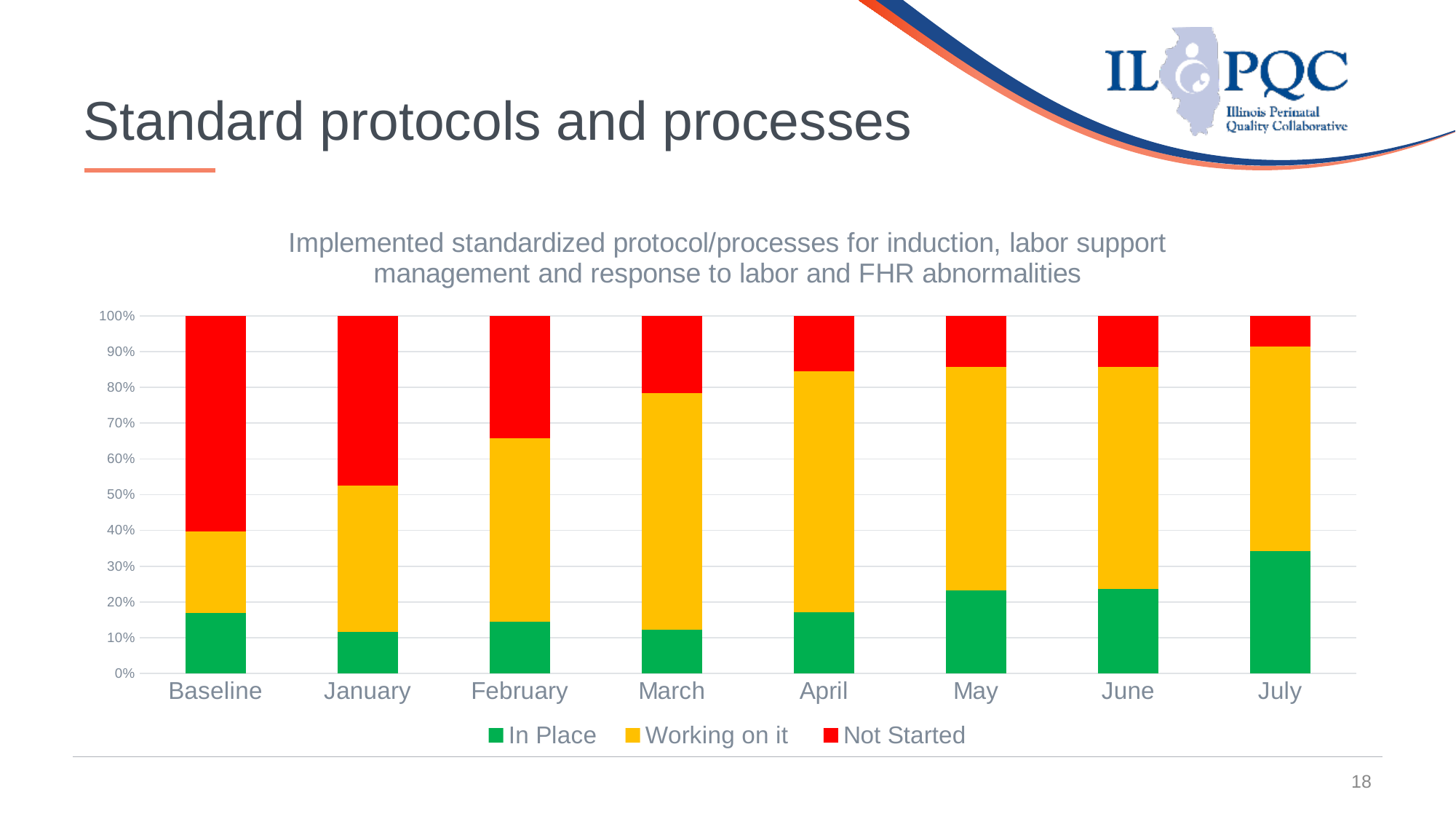
How many time-period categories are shown along the x axis? 8 Does the Not Started share rise or fall from Baseline to July? Fall Is the In Place share for July greater or less than 30%? greater In which period is the In Place share the highest? July Which series are listed in the legend? In Place, Working on it, Not Started Is the Not Started share for January greater or less than 40%? greater How many series does the legend list? 3 In which period is the Not Started share the largest? Baseline What kind of chart is shown on the slide? Stacked bar chart In which period is the Not Started share the smallest? July Which has a larger Not Started share, Baseline or July? Baseline Is the In Place share for Baseline greater or less than 20%? less